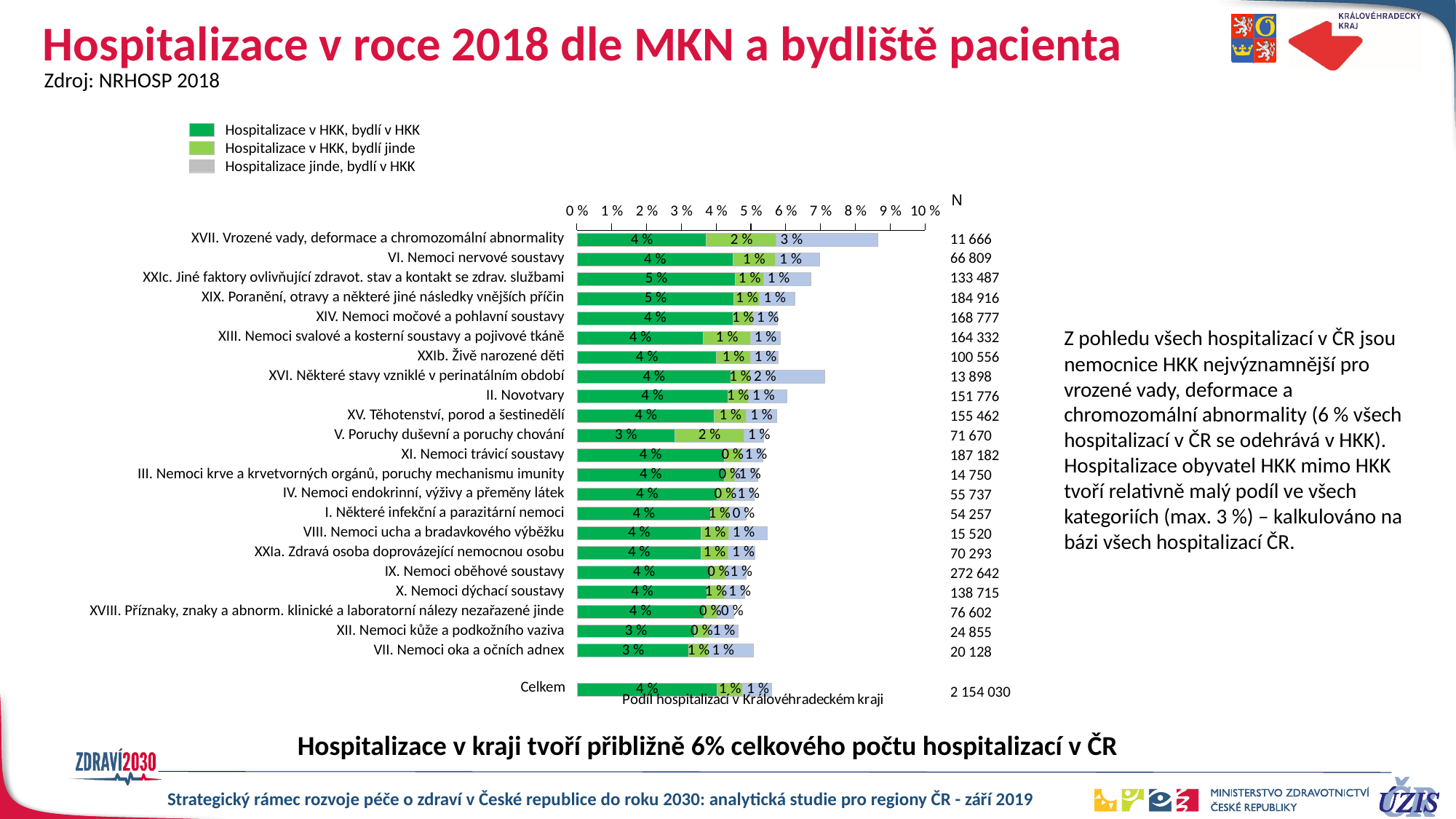
Which has a larger N value: 'XIX. Poranění, otravy a některé jiné následky vnějších příčin' or 'XI. Nemoci trávicí soustavy'? XI. Nemoci trávicí soustavy What is the total of the stacked bar for 'XVII. Vrozené vady, deformace a chromozomální abnormality' based on the printed labels? 9 % How many series does the legend list? 3 What is the value of 'Hospitalizace v HKK, bydlí v HKK' for 'XXIc. Jiné faktory ovlivňující zdravot. stav a kontakt se zdrav. službami'? 5 % Which diagnosis category (excluding Celkem) has the lowest N value? XVII. Vrozené vady, deformace a chromozomální abnormality What kind of chart is shown on the slide? Stacked horizontal bar chart What is the N value shown for 'Celkem'? 2 154 030 What is the x-axis label of the chart? Podíl hospitalizací v Královéhradeckém kraji Which diagnosis category (excluding Celkem) has the highest N value? IX. Nemoci oběhové soustavy How many diagnosis categories (excluding Celkem) are plotted in the chart? 22 What is the N value shown for 'IX. Nemoci oběhové soustavy'? 272 642 What is the value of 'Hospitalizace v HKK, bydlí jinde' for 'XVII. Vrozené vady, deformace a chromozomální abnormality'? 2 %